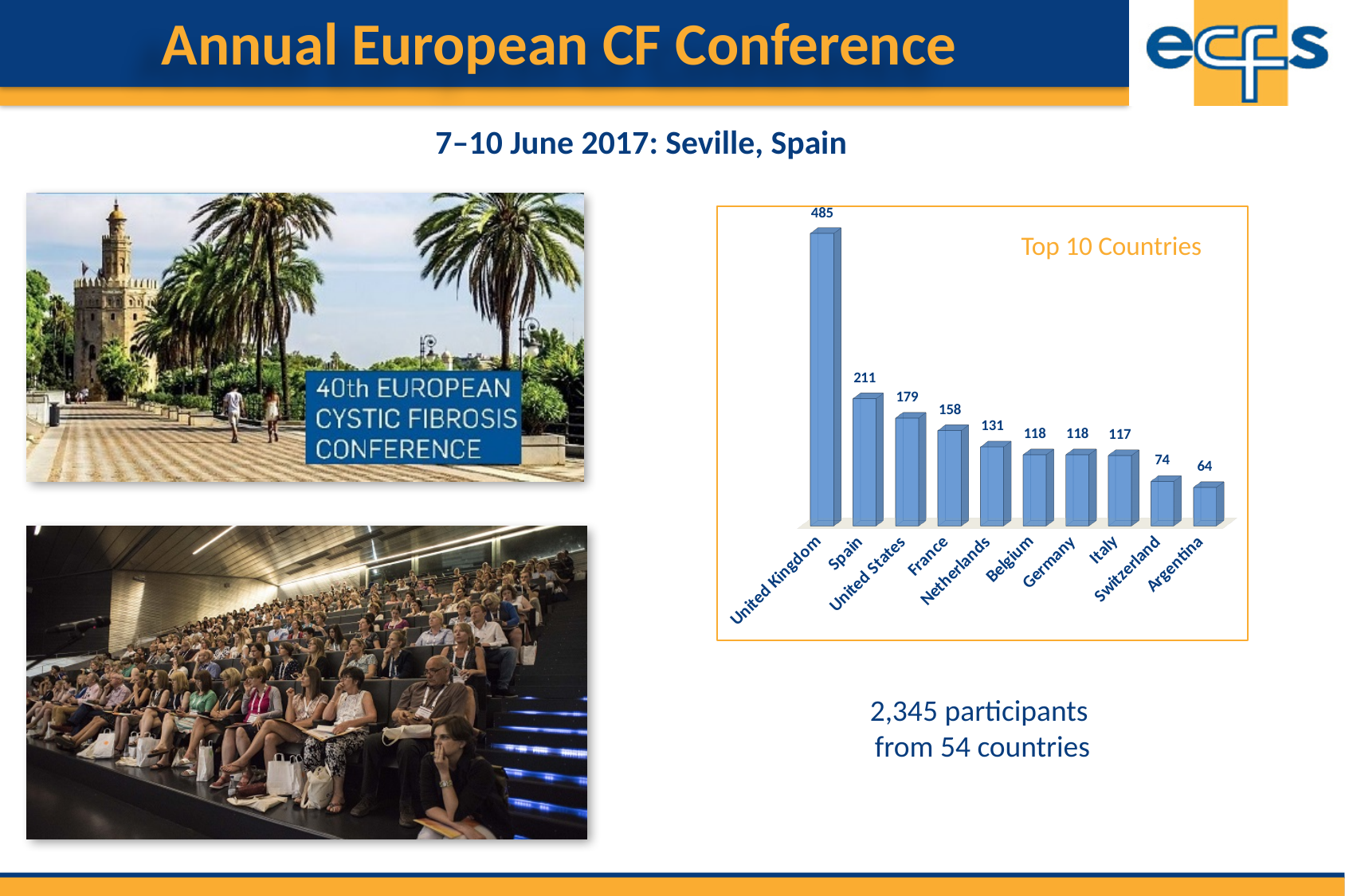
What kind of chart is the Top 10 Countries chart? Bar chart What is the value for Spain in the Top 10 Countries chart? 211 Which has a larger value in the Top 10 Countries chart, United States or France? United States Which country has the lowest value in the Top 10 Countries chart? Argentina How many countries are shown in the Top 10 Countries chart? 10 What is the difference between the values for the United Kingdom and Spain in the Top 10 Countries chart? 274 What is the value for Switzerland in the Top 10 Countries chart? 74 Which country has the highest value in the Top 10 Countries chart? United Kingdom What is the value for the United Kingdom in the Top 10 Countries chart? 485 What is the difference between the values for France and Argentina in the Top 10 Countries chart? 94 Do the values in the Top 10 Countries chart rise or fall from left to right? Fall What is the value for the Netherlands in the Top 10 Countries chart? 131